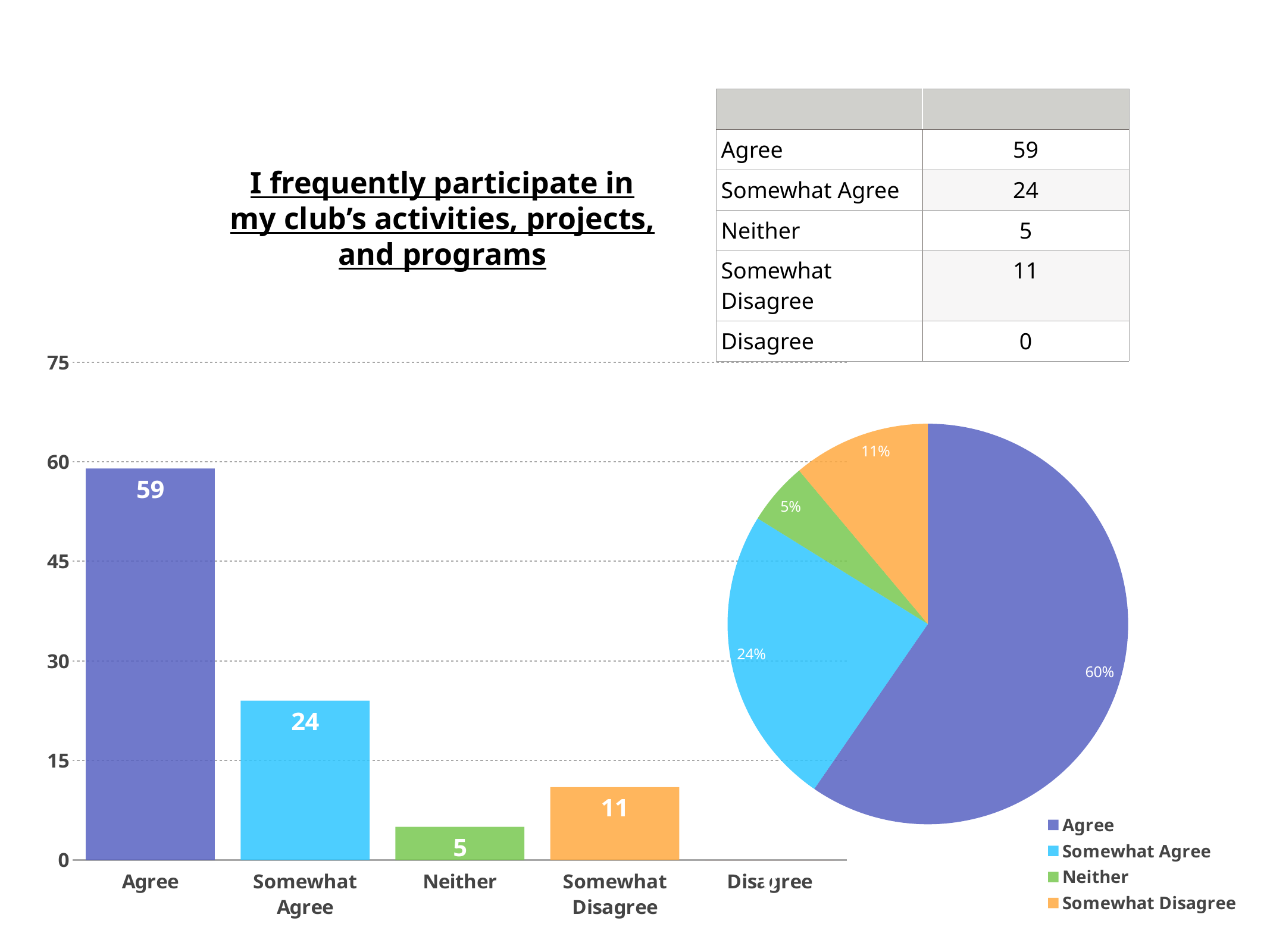
In the bar chart on the left, which category has the highest value? Agree In the pie chart on the right, what colour is the Neither slice? green What kind of chart is the chart on the left of the slide? bar chart In the bar chart on the left, which is larger, the value for Neither or the value for Somewhat Disagree? Somewhat Disagree In the pie chart on the right, what share does the Agree slice have? 60% In the pie chart on the right, what share does the Somewhat Agree slice have? 24% In the bar chart on the left, what is the difference between the values for Agree and Somewhat Agree? 35 In the bar chart on the left, what is the value for Agree? 59 How many categories are shown on the x axis of the bar chart on the left? 5 In the bar chart on the left, what is the value for Somewhat Disagree? 11 In the bar chart on the left, which category has the lowest value? Disagree How many entries does the legend of the pie chart on the right list? 4